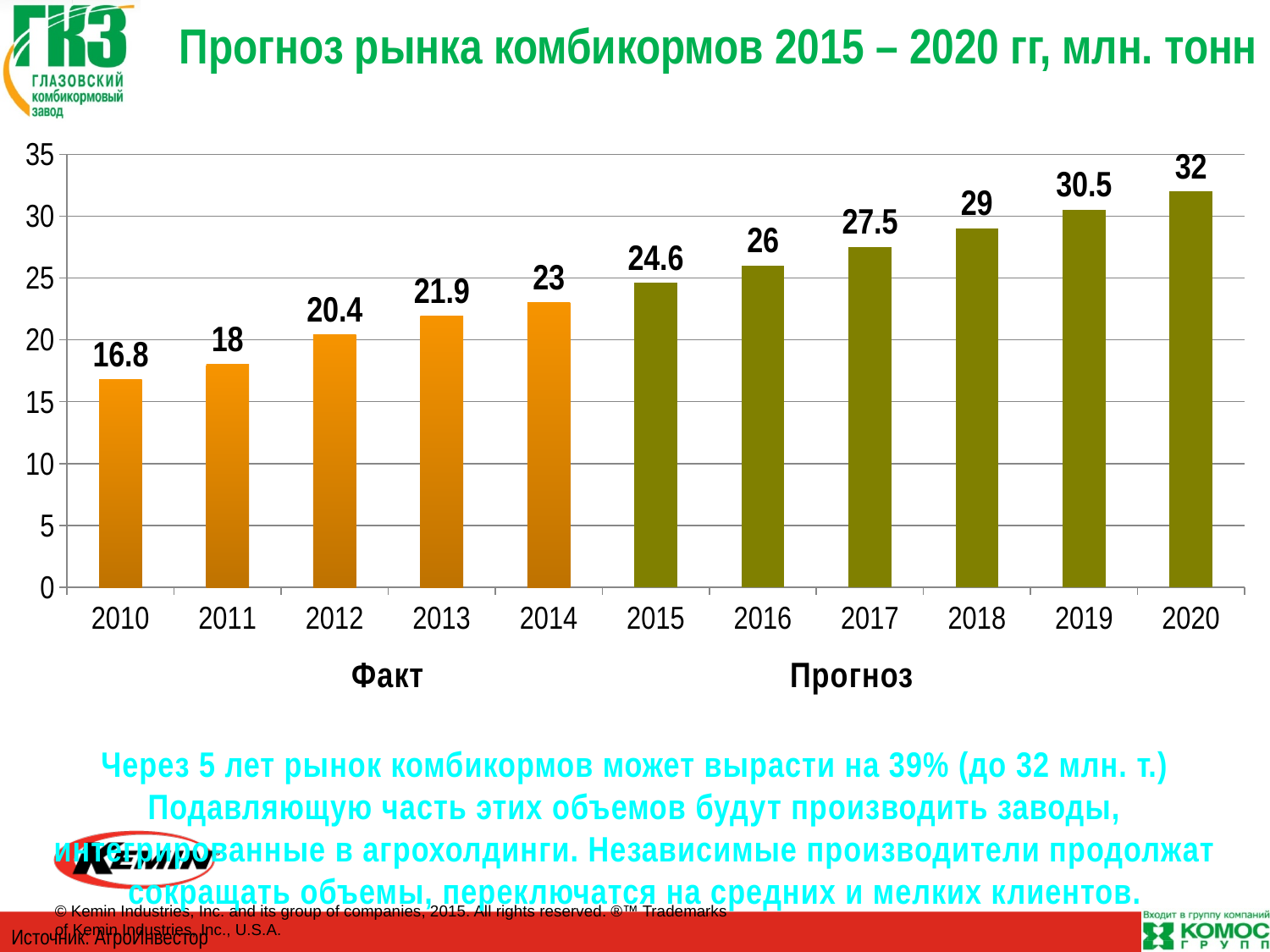
Is the value for 2019 greater or less than 30? greater Which year has the highest value? 2020 What is the value for 2014? 23 Which year has the lowest value? 2010 Which two groups are labelled below the x axis? Факт and Прогноз What kind of chart is this? bar chart How many years are shown on the x axis? 11 What is the difference between the values for 2020 and 2015? 7.4 Do the values rise or fall from 2010 to 2020? rise What is the value for 2010? 16.8 Which is larger, the value for 2013 or the value for 2016? 2016 What is the value for 2017? 27.5